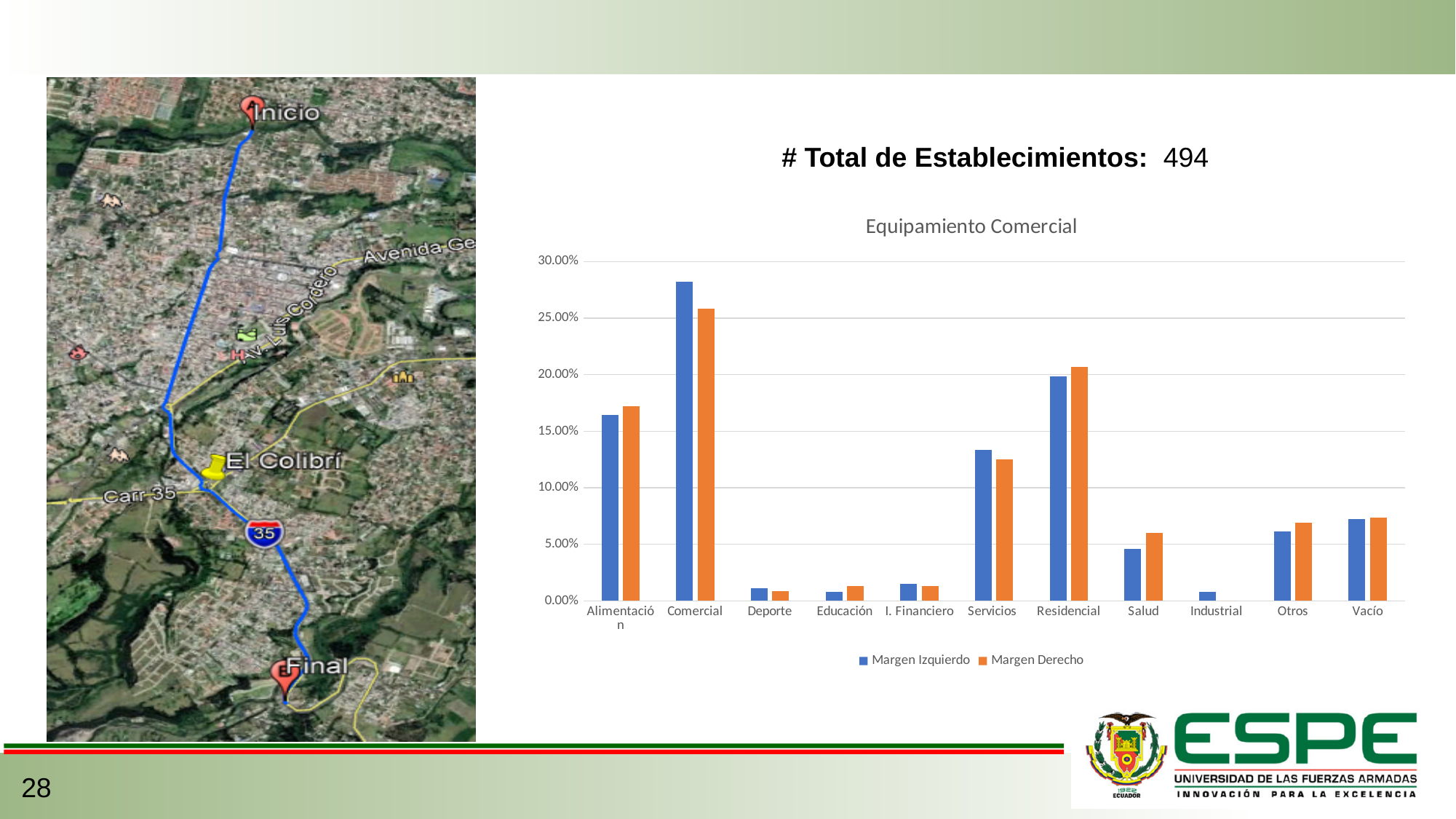
How many categories are shown on the x axis of the chart? 11 What is the title of the chart? Equipamiento Comercial How many series does the chart legend list? 2 For Comercial, which series has the larger value, Margen Izquierdo or Margen Derecho? Margen Izquierdo Which category has the highest value for Margen Izquierdo? Comercial What type of chart is shown on the slide? bar chart Is the Margen Derecho value for Alimentación greater or less than 15.00%? greater Is the Margen Izquierdo value for Salud greater or less than 5.00%? less Which category has the highest value for Margen Derecho? Comercial For Salud, which series has the larger value, Margen Izquierdo or Margen Derecho? Margen Derecho Is the Margen Izquierdo value for Comercial greater or less than 25.00%? greater Which category has the lowest value for Margen Derecho? Industrial